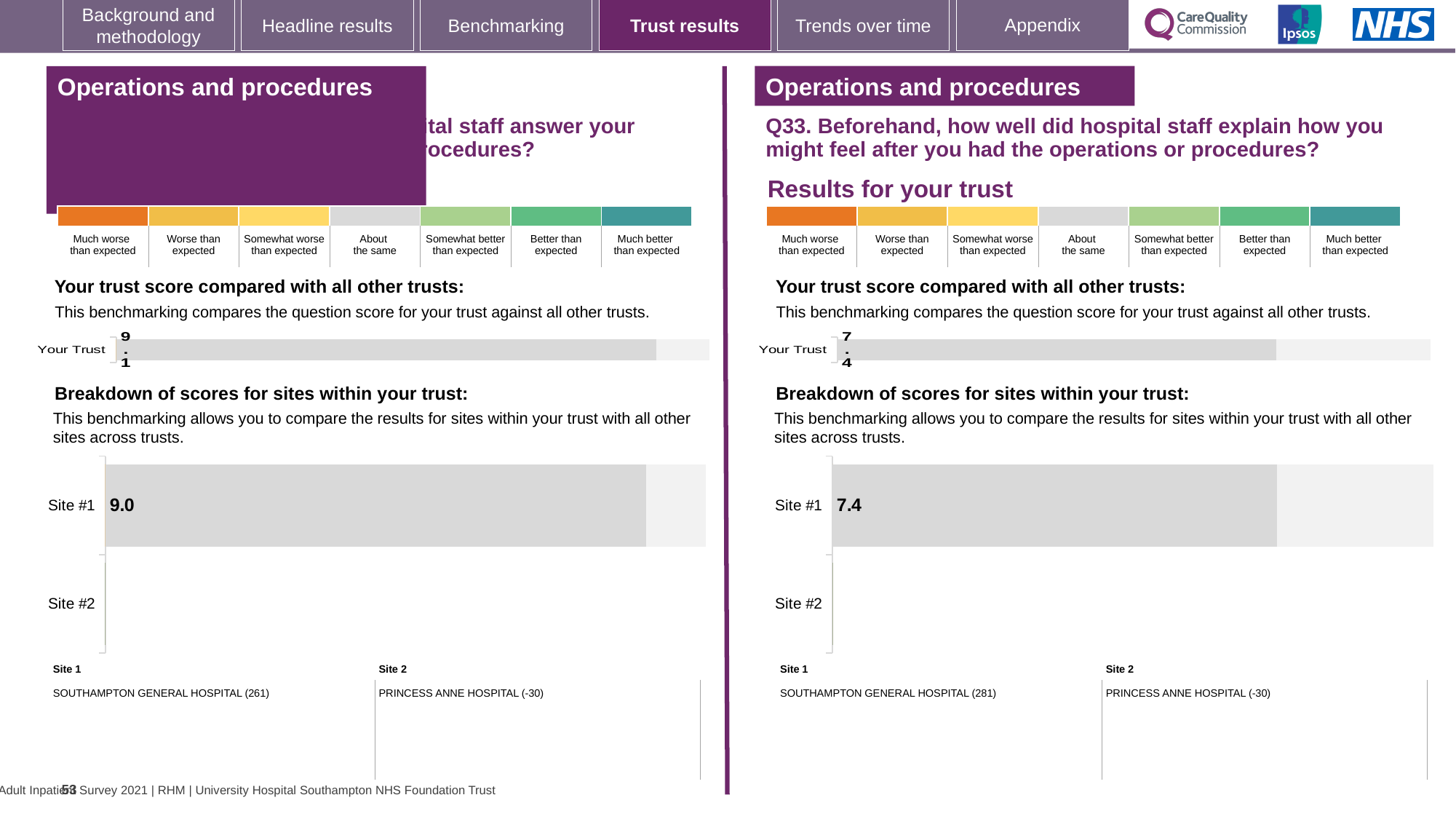
How many sites are listed in the right-hand 'Breakdown of scores for sites within your trust' chart? 2 What is the difference between the Site #1 score in the left-hand breakdown chart (9.0) and the Site #1 score in the right-hand Q33 breakdown chart (7.4)? 1.6 In the right-hand 'Your trust score compared with all other trusts' chart for Q33, what is the score shown for Your Trust? 7.4 In the left-hand 'Your trust score compared with all other trusts' chart, what is the score shown for Your Trust? 9.1 What kind of chart is the 'Breakdown of scores for sites within your trust' chart on the right-hand side? Bar chart How many rating categories are shown in the colour scale above the right-hand Q33 charts, from 'Much worse than expected' to 'Much better than expected'? 7 Which is larger: the Site #1 score in the left-hand breakdown chart or the Site #1 score in the right-hand Q33 breakdown chart? Left-hand chart (9.0) In the left-hand 'Breakdown of scores for sites within your trust' chart, what is the score for Site #1? 9.0 In the right-hand 'Breakdown of scores for sites within your trust' chart for Q33, what is the score for Site #1? 7.4 In the left-hand 'Your trust score' chart, what is the difference between the Your Trust score (9.1) and the Site #1 score (9.0) in the breakdown chart below it? 0.1 According to the site key under the right-hand Q33 breakdown chart, which hospital is Site 1? SOUTHAMPTON GENERAL HOSPITAL Which is larger: the Your Trust score in the left-hand chart or the Your Trust score in the right-hand Q33 chart? Left-hand chart (9.1)